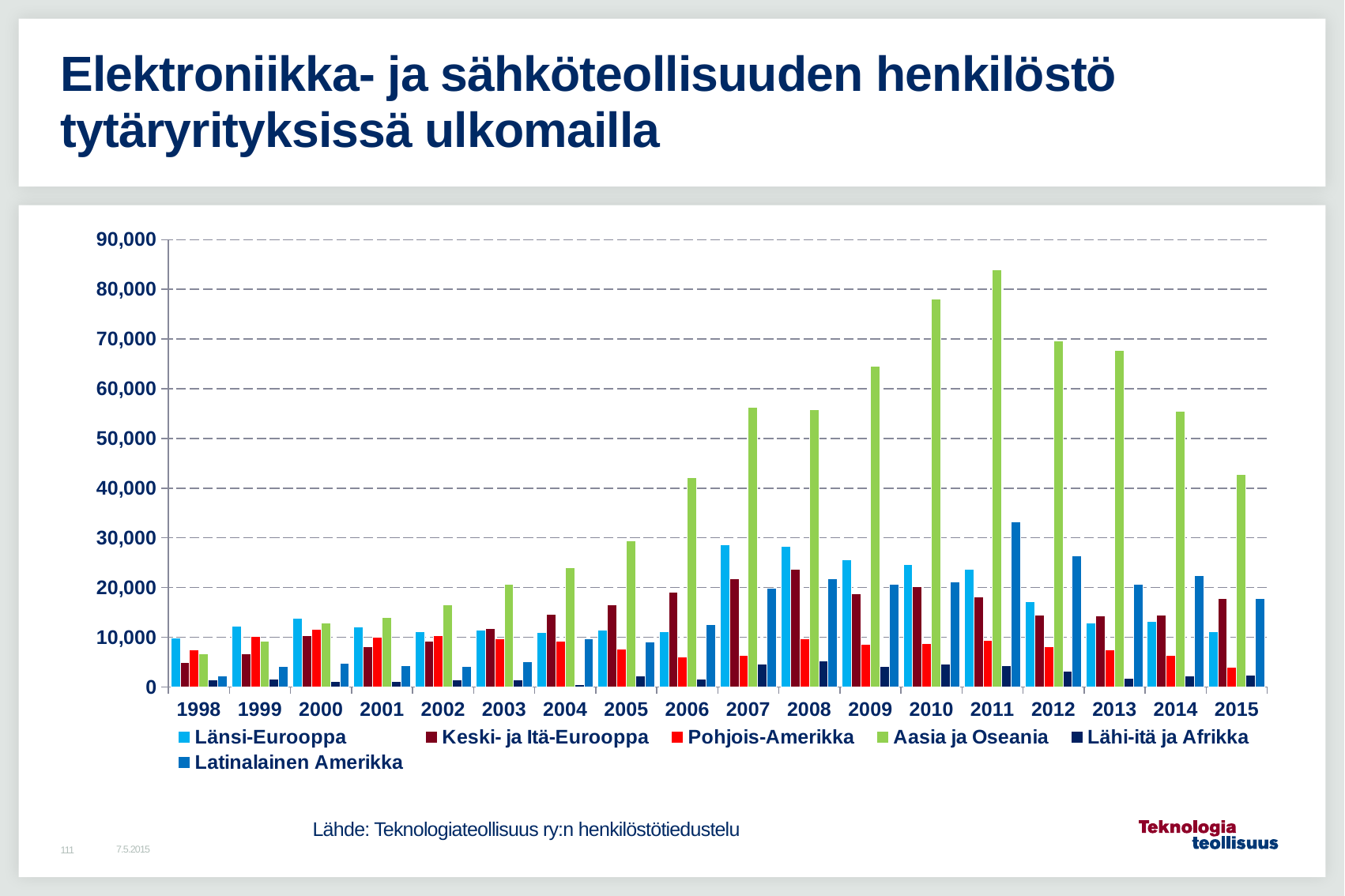
How many years are shown on the x axis? 18 Is the value for Aasia ja Oseania in 2010 greater or less than 80,000? less In which year is the value for Aasia ja Oseania lowest? 1998 Is the value for Aasia ja Oseania in 2015 greater or less than 40,000? greater Which series has the highest value in 2015? Aasia ja Oseania How many series does the legend list? 6 Which is larger: the value for Latinalainen Amerikka in 2011 or in 2012? 2011 What kind of chart is shown on the slide? bar chart Is the value for Latinalainen Amerikka in 2011 greater or less than 30,000? greater Does the value for Aasia ja Oseania rise or fall from 1998 to 2011? rise In which year is the value for Aasia ja Oseania highest? 2011